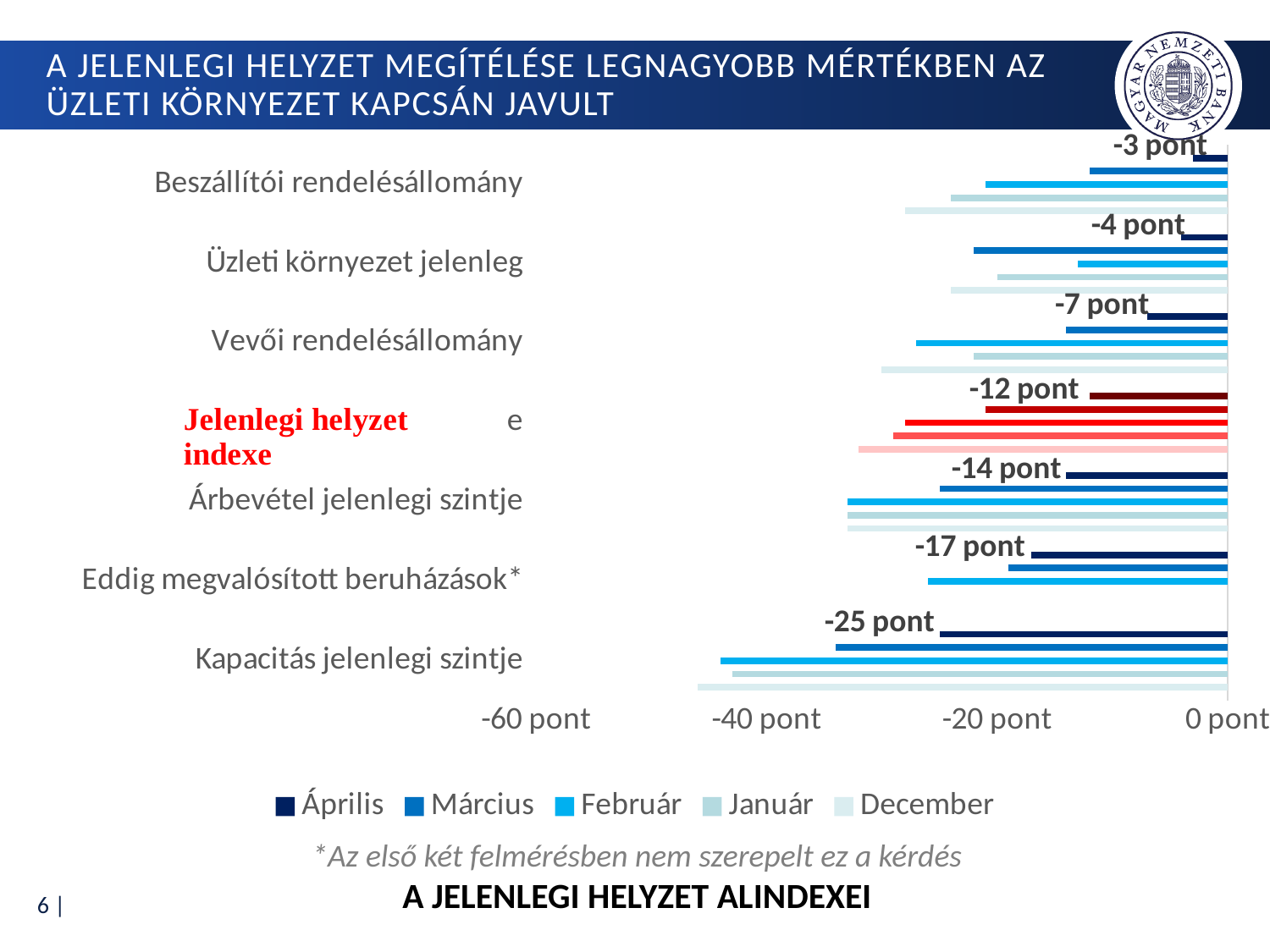
What is the Április value for Jelenlegi helyzet indexe? -12 pont Which category has the lowest Április value? Kapacitás jelenlegi szintje Which is larger, the Április value for Üzleti környezet jelenleg or for Eddig megvalósított beruházások*? Üzleti környezet jelenleg What is the Április value for Kapacitás jelenlegi szintje? -25 pont How many series does the legend list? 5 What kind of chart is shown on the slide? Bar chart Is the Március value for Kapacitás jelenlegi szintje greater or less than -40 pont? greater What is the difference between the Április values for Árbevétel jelenlegi szintje and Vevői rendelésállomány? 7 pont What is the Április value for Eddig megvalósított beruházások*? -17 pont Which category has the highest Április value? Beszállítói rendelésállomány What is the Április value for Üzleti környezet jelenleg? -4 pont How many categories are shown on the chart? 7